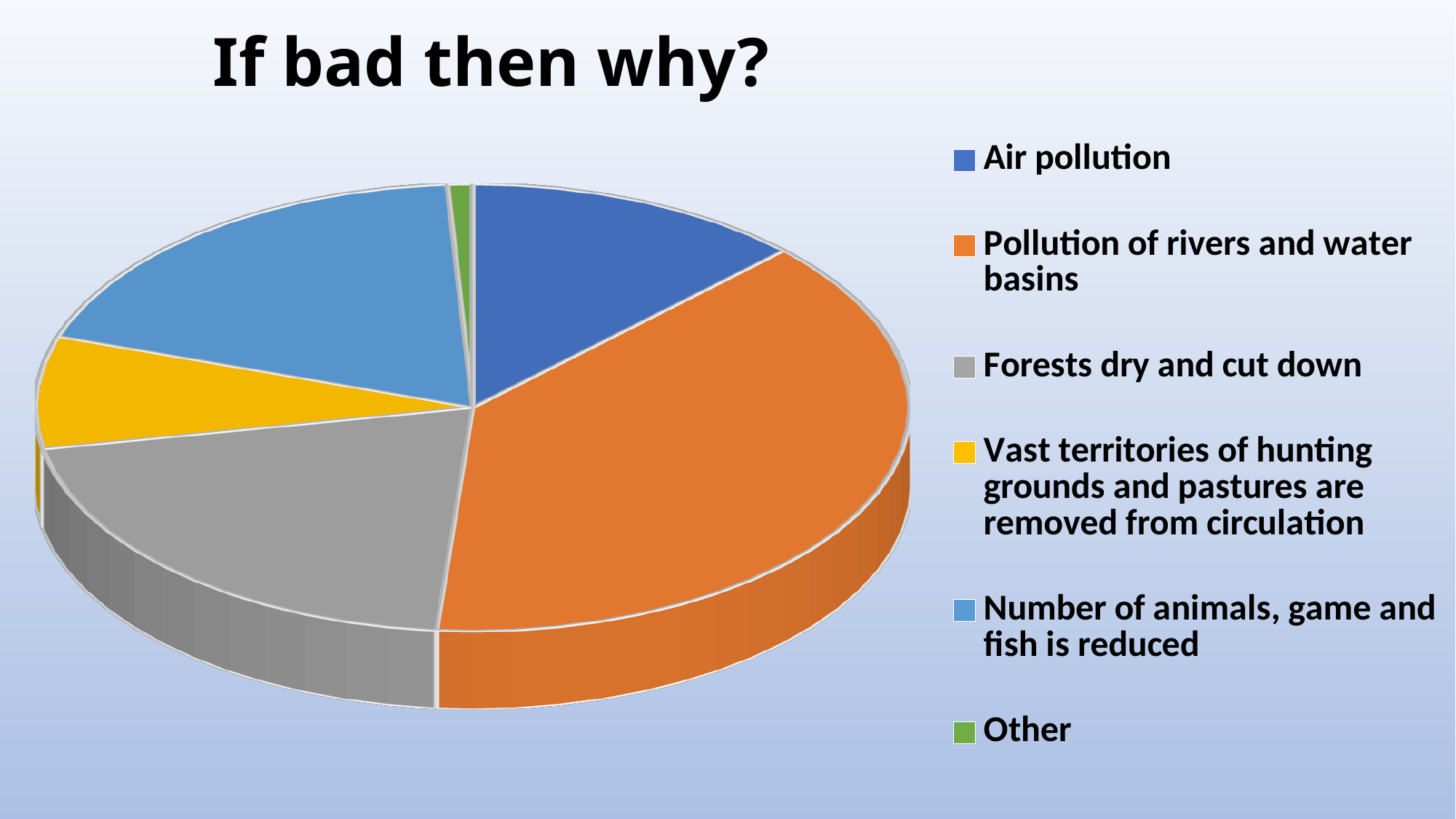
Which slice is larger: Air pollution or Pollution of rivers and water basins? Pollution of rivers and water basins Which slice is larger: Forests dry and cut down or Vast territories of hunting grounds and pastures are removed from circulation? Forests dry and cut down Which slice is larger: Air pollution or Number of animals, game and fish is reduced? Number of animals, game and fish is reduced How many categories (slices) does the pie chart have? 6 Which category has the largest slice of the pie? Pollution of rivers and water basins What colour is the slice for Other in the pie chart? Green What is the title of the slide containing the pie chart? If bad then why? What kind of chart is shown on the slide? Pie chart Which category has the smallest slice of the pie? Other